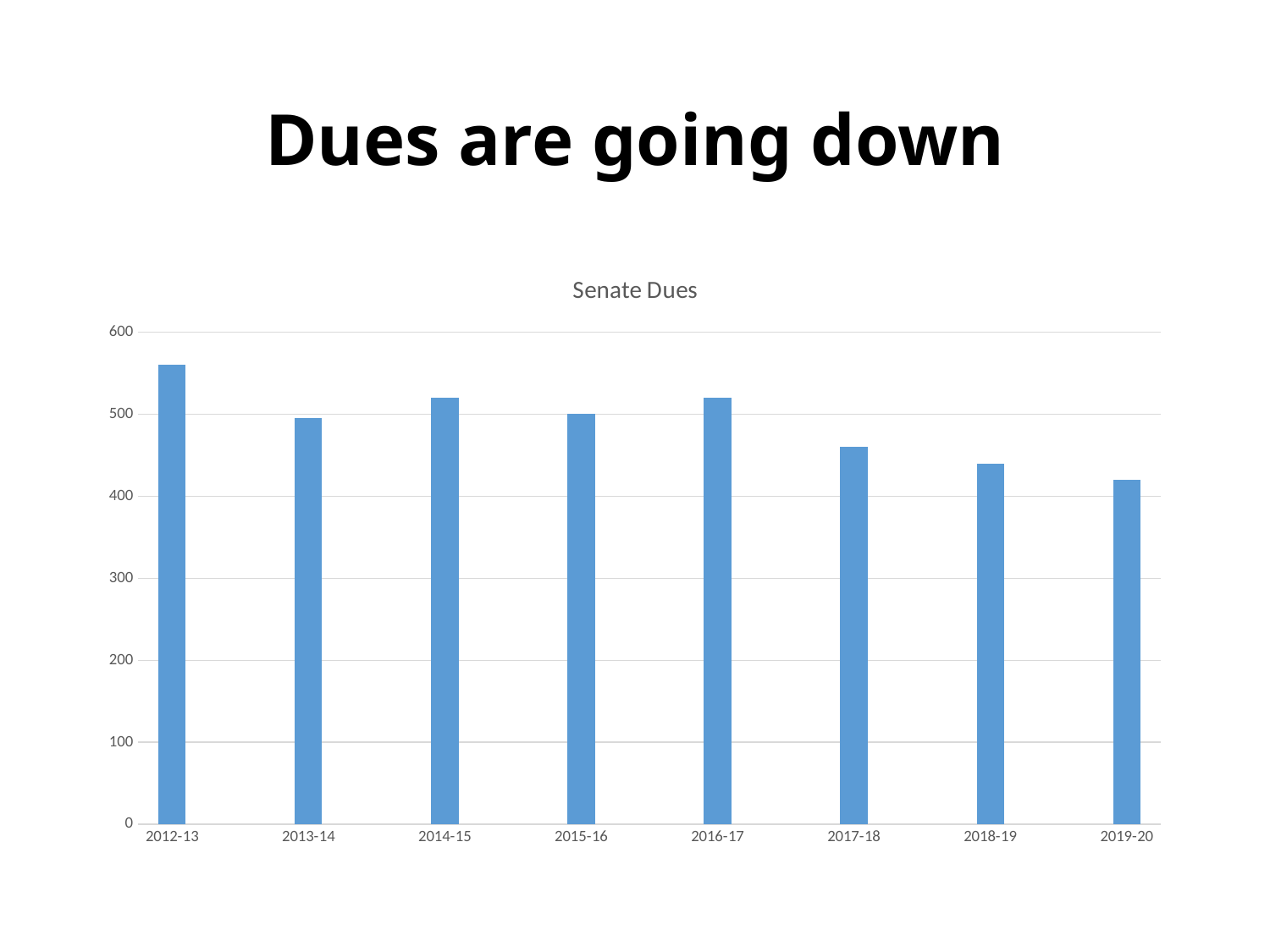
Which is larger, the value for 2012-13 or the value for 2019-20? 2012-13 Do the Senate Dues values generally rise or fall from 2012-13 to 2019-20? fall What is the title of the chart? Senate Dues Which year has the lowest Senate Dues? 2019-20 Which is larger, the value for 2014-15 or the value for 2017-18? 2014-15 Is the value for 2012-13 greater or less than 500? greater How many years are shown on the x axis of the chart? 8 Is the value for 2019-20 greater or less than 500? less Is the value for 2018-19 greater or less than 400? greater Which year has the highest Senate Dues? 2012-13 What kind of chart is shown on the slide? bar chart